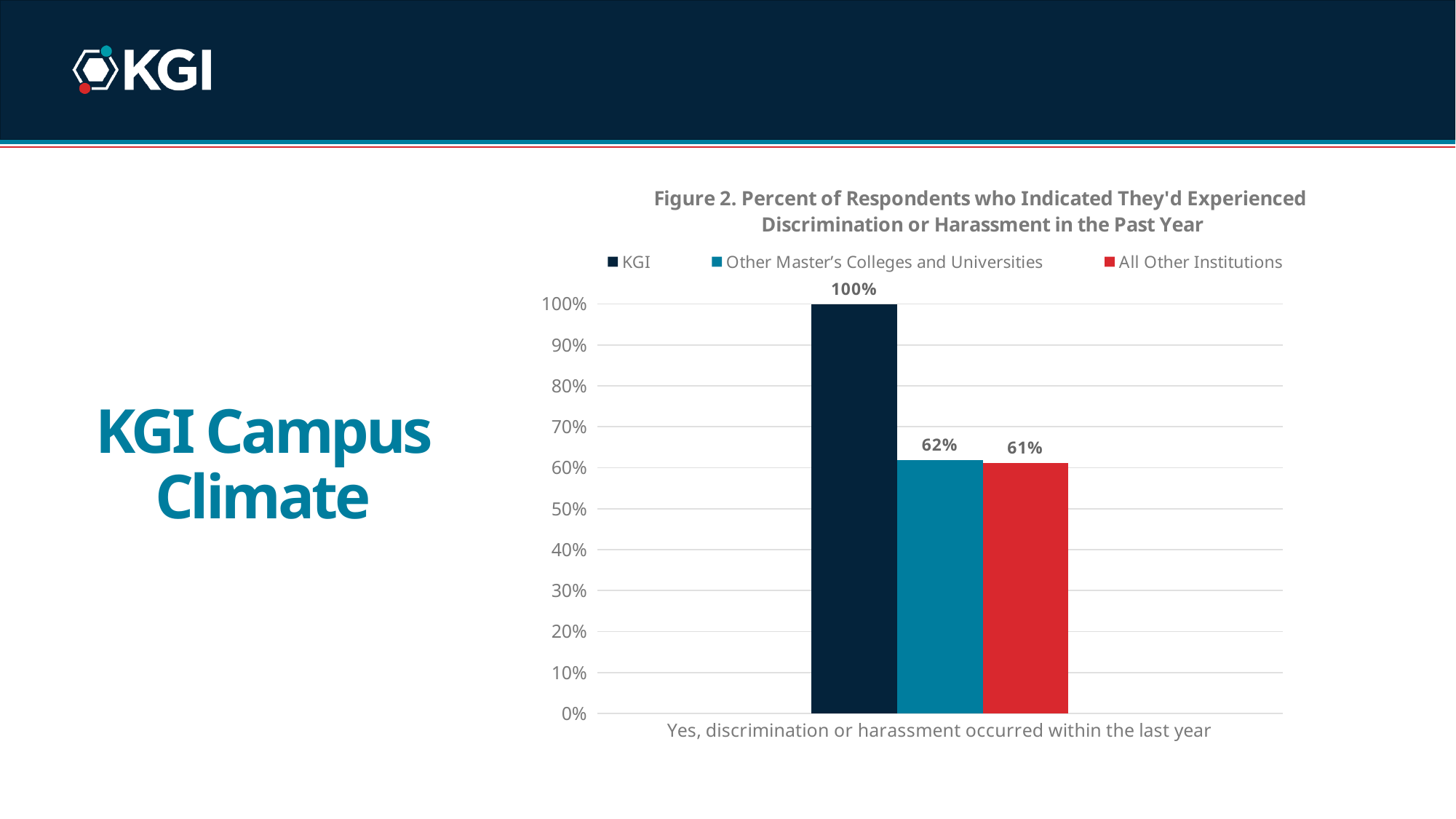
Which is larger, the value for KGI or the value for All Other Institutions? KGI What is the value for KGI? 100% Which series has the highest value? KGI Which series has the lowest value? All Other Institutions Is the value for Other Master's Colleges and Universities greater or less than 50%? greater What kind of chart is shown on the slide? Bar chart What is the difference between the KGI value and the Other Master's Colleges and Universities value? 38% What is the value for All Other Institutions? 61% What is the value for Other Master's Colleges and Universities? 62% How many series does the legend list? 3 What is the difference between the Other Master's Colleges and Universities value and the All Other Institutions value? 1% What is the category label on the x axis? Yes, discrimination or harassment occurred within the last year